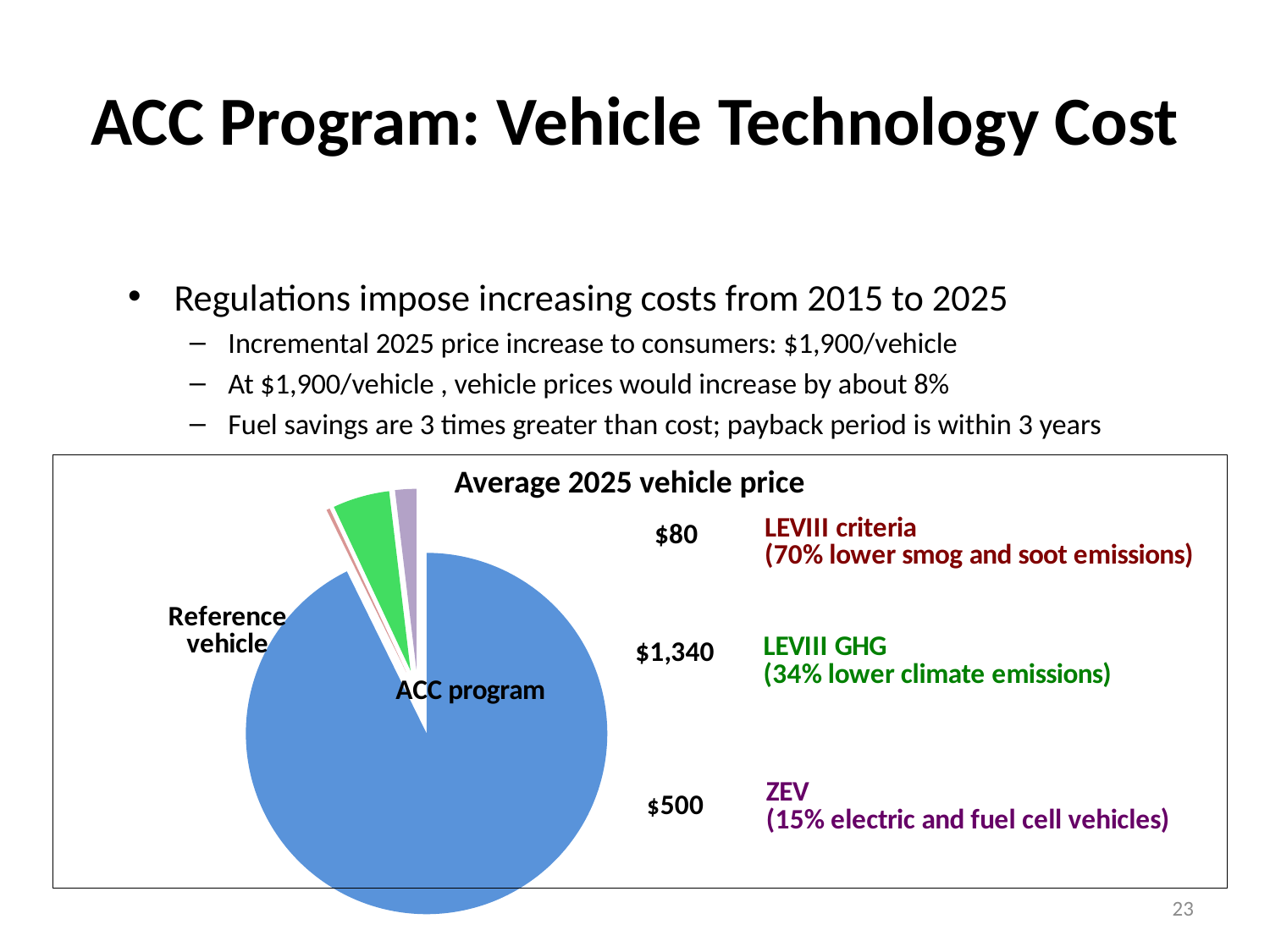
What is the difference between the ZEV value and the LEVIII criteria value? $420 What is the value shown for LEVIII criteria? $80 What is the value shown for ZEV? $500 Which is larger, the value for ZEV or the value for LEVIII criteria? ZEV How many slices does the pie chart have? 4 Among the three ACC program components (LEVIII criteria, LEVIII GHG, ZEV), which has the lowest value? LEVIII criteria Among the three ACC program components (LEVIII criteria, LEVIII GHG, ZEV), which has the highest value? LEVIII GHG Which slice of the pie is the largest? Reference vehicle What is the value shown for LEVIII GHG? $1,340 What is the title of the chart? Average 2025 vehicle price What kind of chart is shown on the slide? pie chart What is the difference between the LEVIII GHG value and the ZEV value? $840